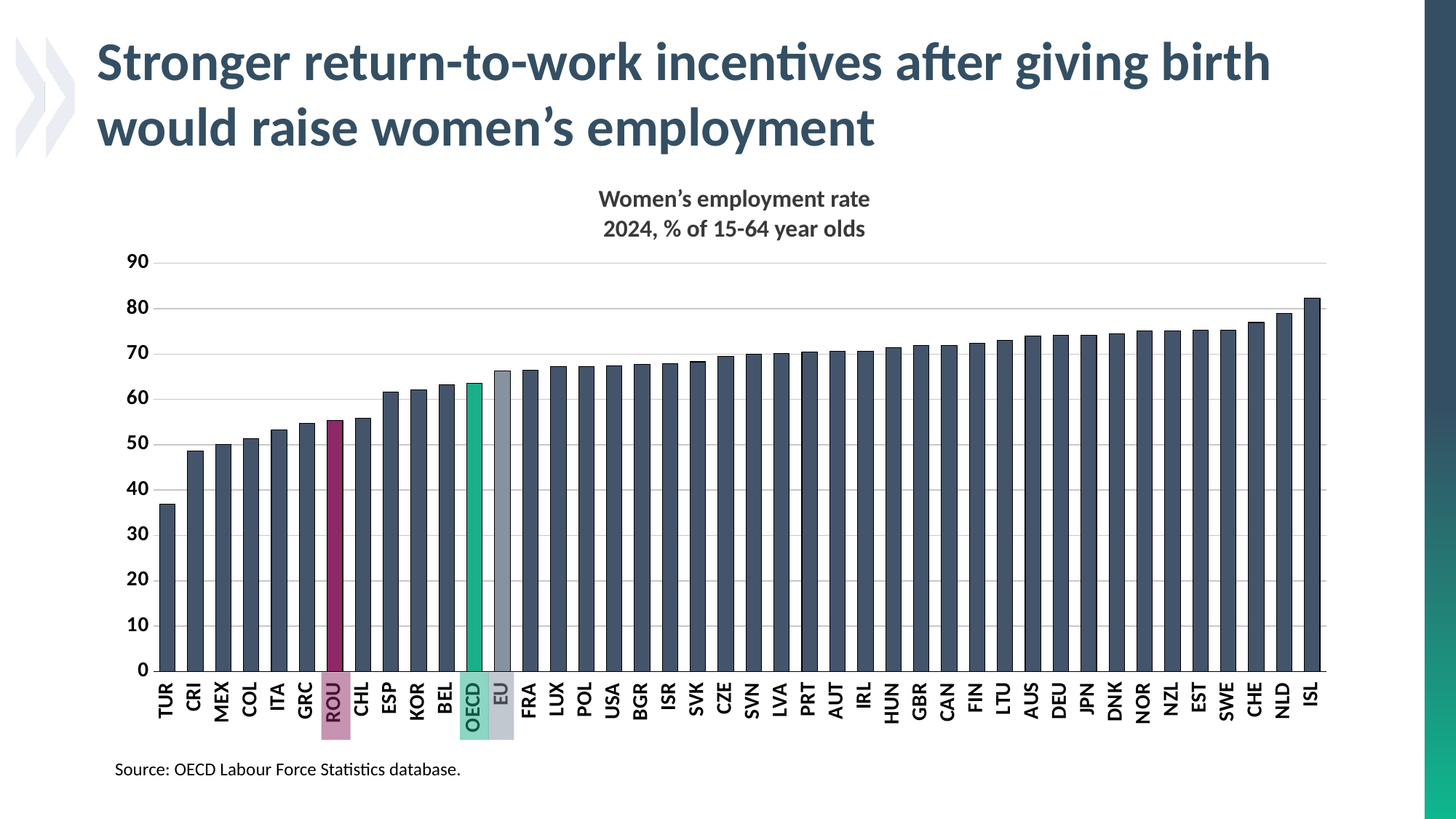
Is the value for TUR greater or less than 40? less What kind of chart is shown on the slide? bar chart Which country has the highest women's employment rate in the chart? ISL Do the values rise or fall moving from left to right along the x axis? rise Which has a higher women's employment rate, ROU or OECD? OECD How many categories (bars) are shown in the chart? 42 Is the value for OECD greater or less than 60? greater What is the title of the chart? Women's employment rate 2024, % of 15-64 year olds Which country has the lowest women's employment rate in the chart? TUR Is the value for ROU greater or less than 50? greater